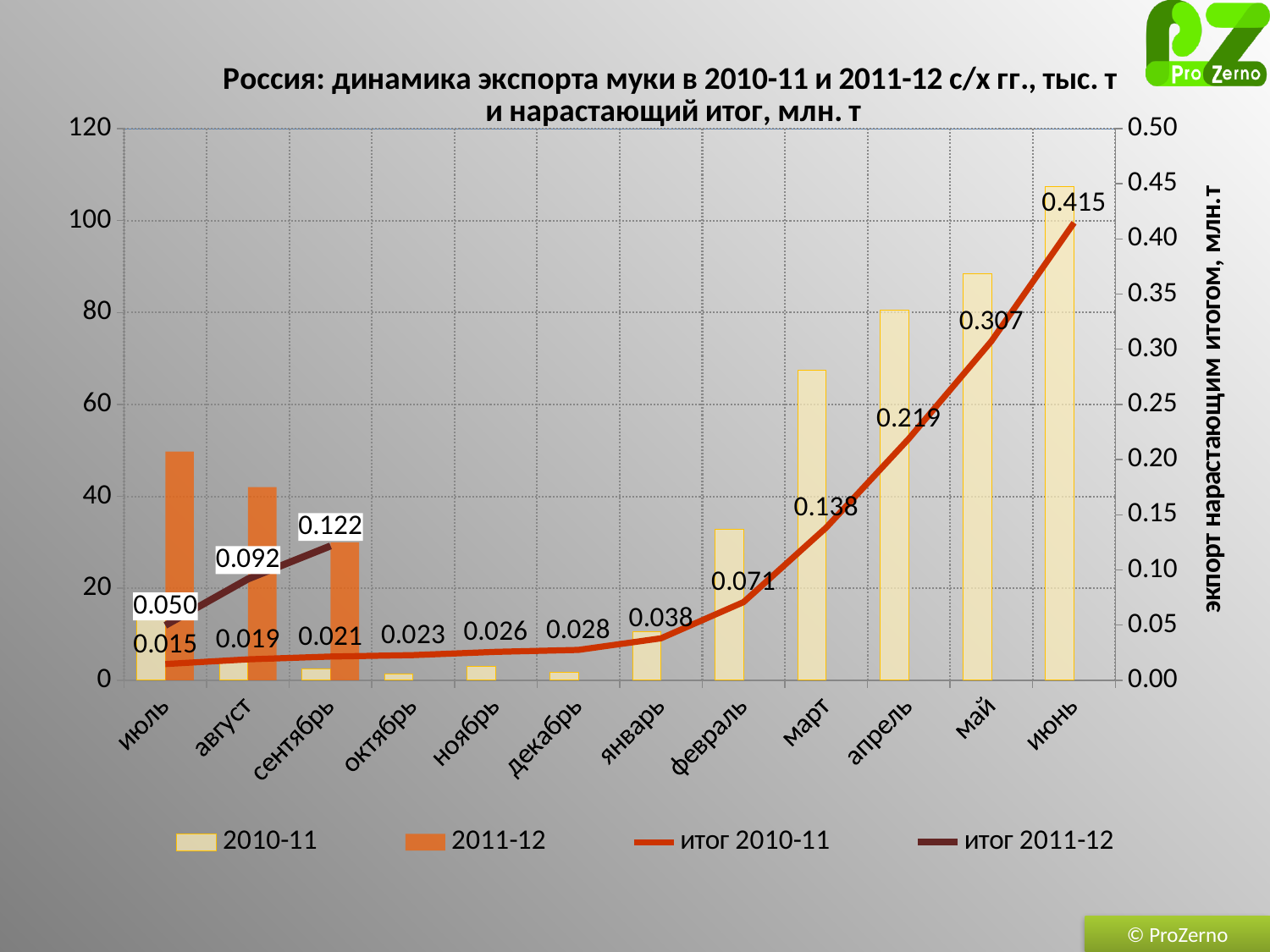
How many months are shown on the x axis? 12 What is the difference between the итог 2011-12 value for август and the итог 2010-11 value for август? 0.073 Is the 2010-11 bar for июнь greater or less than 100? greater What is the value of the итог 2011-12 line for сентябрь? 0.122 What kind of chart is this? Combined bar and line chart Is the 2011-12 bar for июль greater or less than 40? greater Which is larger: the итог 2010-11 value for апрель or for май? май What is the value of the итог 2010-11 line for март? 0.138 How many series does the legend list? 4 Does the итог 2010-11 line rise or fall from июль to июнь? rise What is the value of the итог 2010-11 line for июнь? 0.415 Which month has the lowest value on the итог 2010-11 line? июль